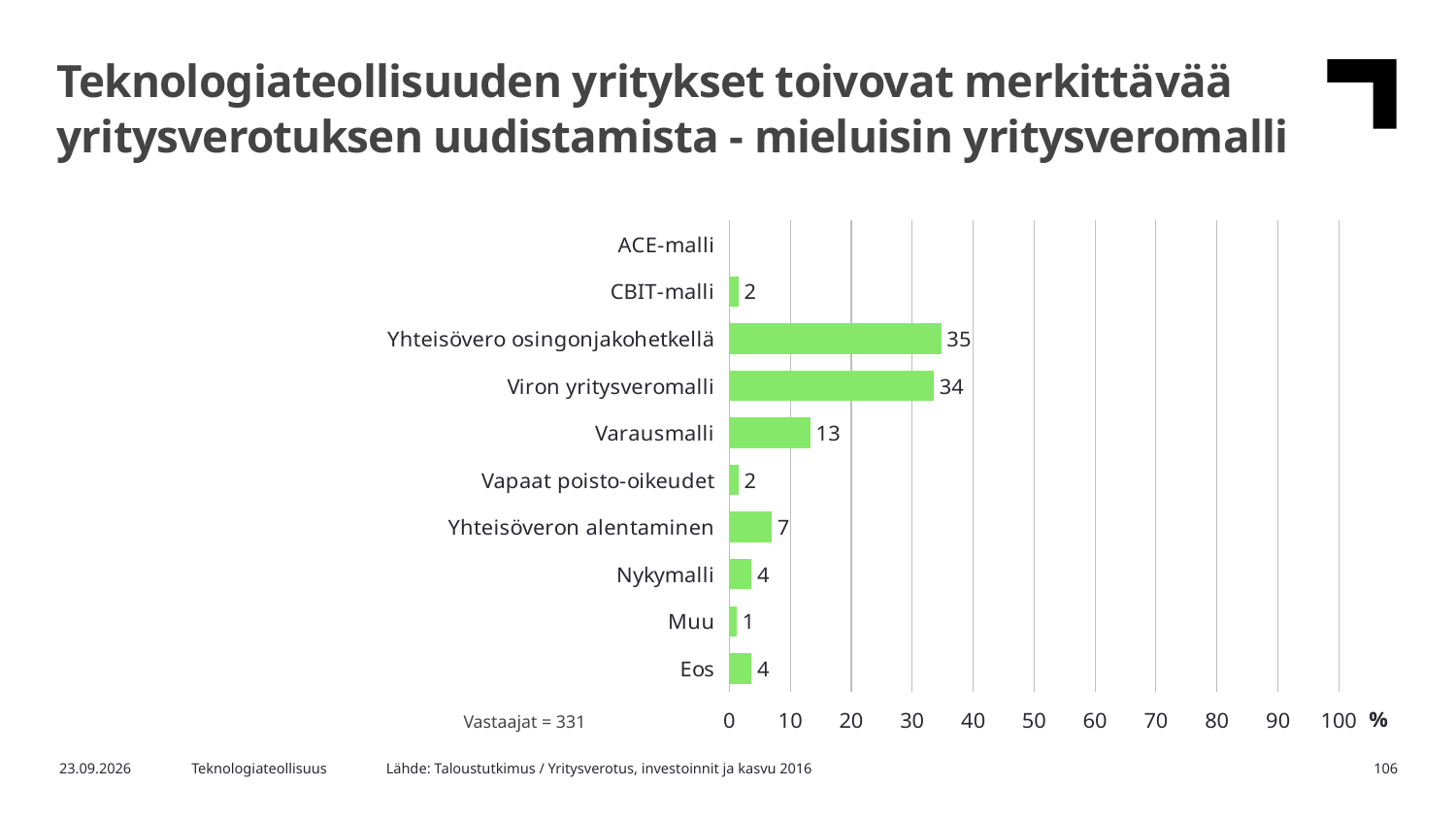
How many categories are listed on the vertical axis? 10 What value is shown for Yhteisöveron alentaminen? 7 What is the difference between the values for Yhteisövero osingonjakohetkellä and Viron yritysveromalli? 1 What kind of chart is shown on the slide? Bar chart What value is shown for Varausmalli? 13 What value is shown for Viron yritysveromalli? 34 What is the number of respondents (Vastaajat) stated below the chart? 331 Which category has the highest value? Yhteisövero osingonjakohetkellä What value is shown for Muu? 1 Is the value for Viron yritysveromalli greater or less than 30? greater What is the difference between the values for Varausmalli and Yhteisöveron alentaminen? 6 Which is larger, the value for Nykymalli or the value for Yhteisöveron alentaminen? Yhteisöveron alentaminen